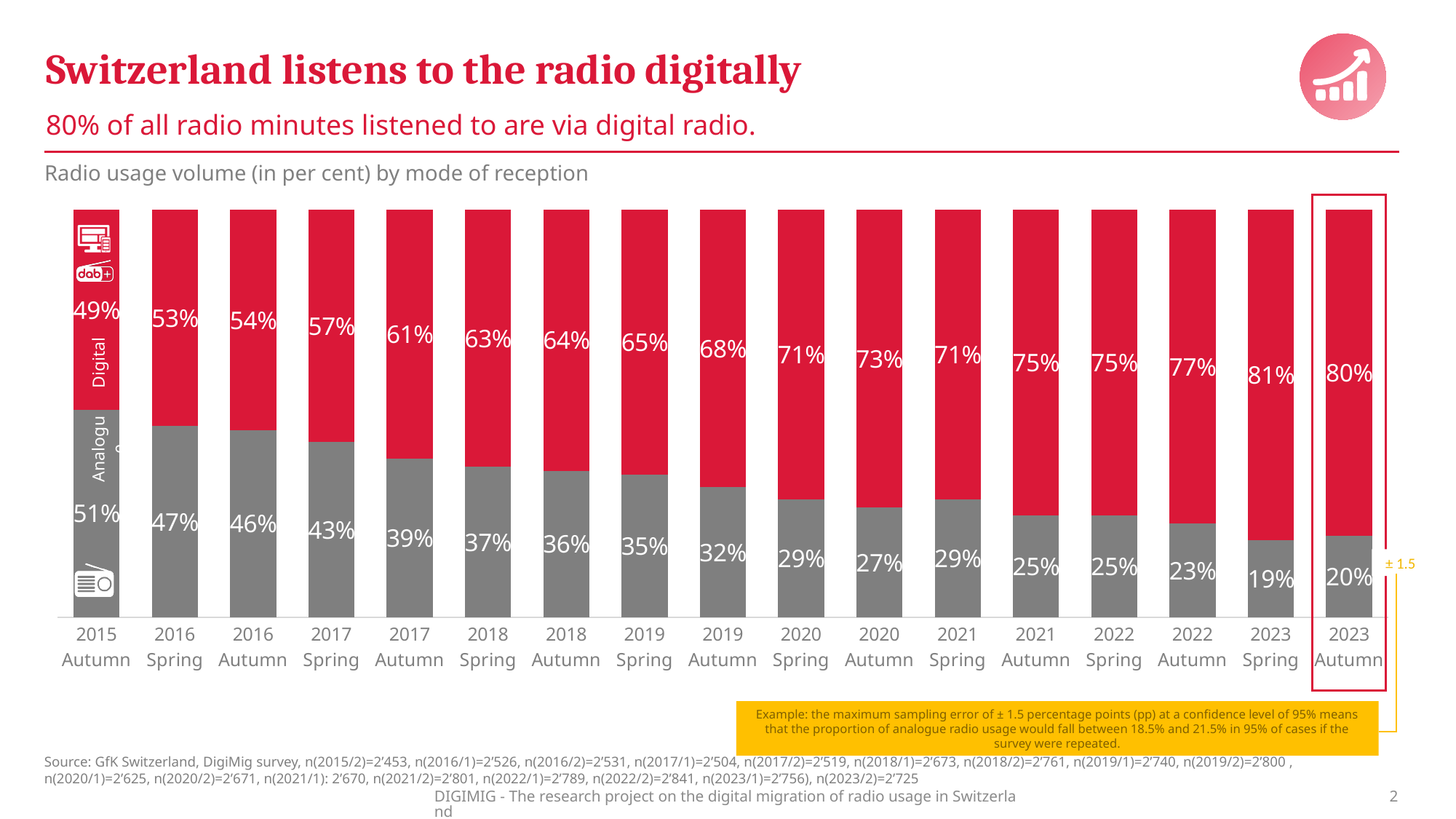
What is the difference between the Digital share in 2023 Autumn and in 2015 Autumn? 31 percentage points Does the Digital share generally rise or fall from 2015 Autumn to 2023 Autumn? Rise What is the Digital share for 2023 Autumn? 80% What is the Analogue share for 2015 Autumn? 51% What kind of chart is shown? Stacked bar chart How many series does the chart show? 2 In which period is the Digital share highest? 2023 Spring Which is larger, the Analogue share in 2017 Spring or in 2018 Autumn? 2017 Spring What is the Analogue share for 2019 Spring? 35% How many periods are shown on the x axis? 17 In which period is the Analogue share lowest? 2023 Spring What is the Digital share for 2020 Autumn? 73%